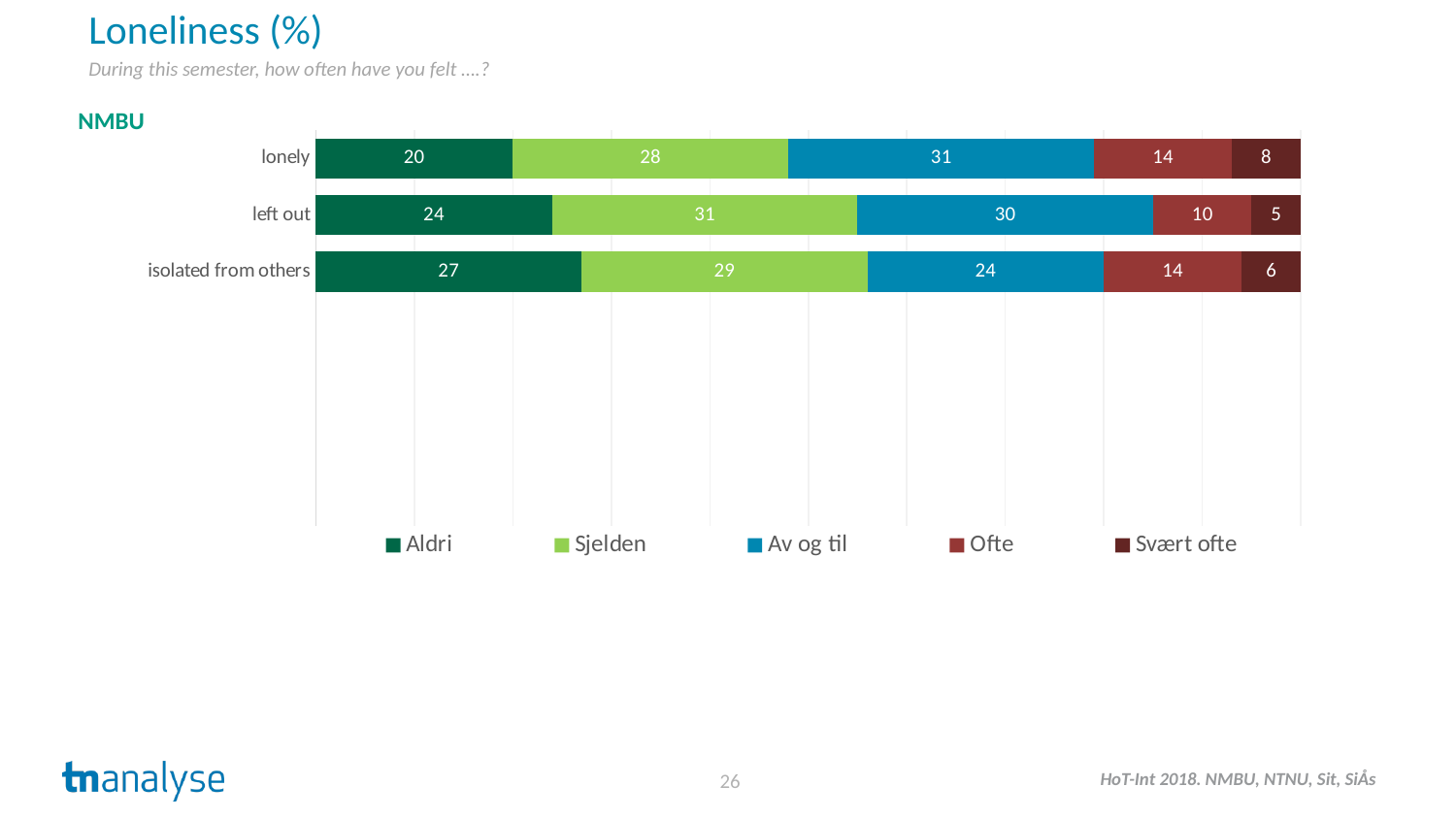
What is the difference between the Sjelden values for 'left out' and 'lonely'? 3 What is the title of the chart? Loneliness (%) What is the Av og til value for 'left out'? 30 How many series does the legend list? 5 Which category has the highest Aldri value? isolated from others What is the Svært ofte value for 'isolated from others'? 6 What kind of chart is shown on the slide? stacked bar chart What is the Aldri value for 'lonely'? 20 What is the total of the stacked bar for 'left out'? 100 How many categories are plotted on the chart? 3 Which is larger, the Av og til value for 'lonely' or for 'isolated from others'? lonely Which category has the lowest Ofte value? left out